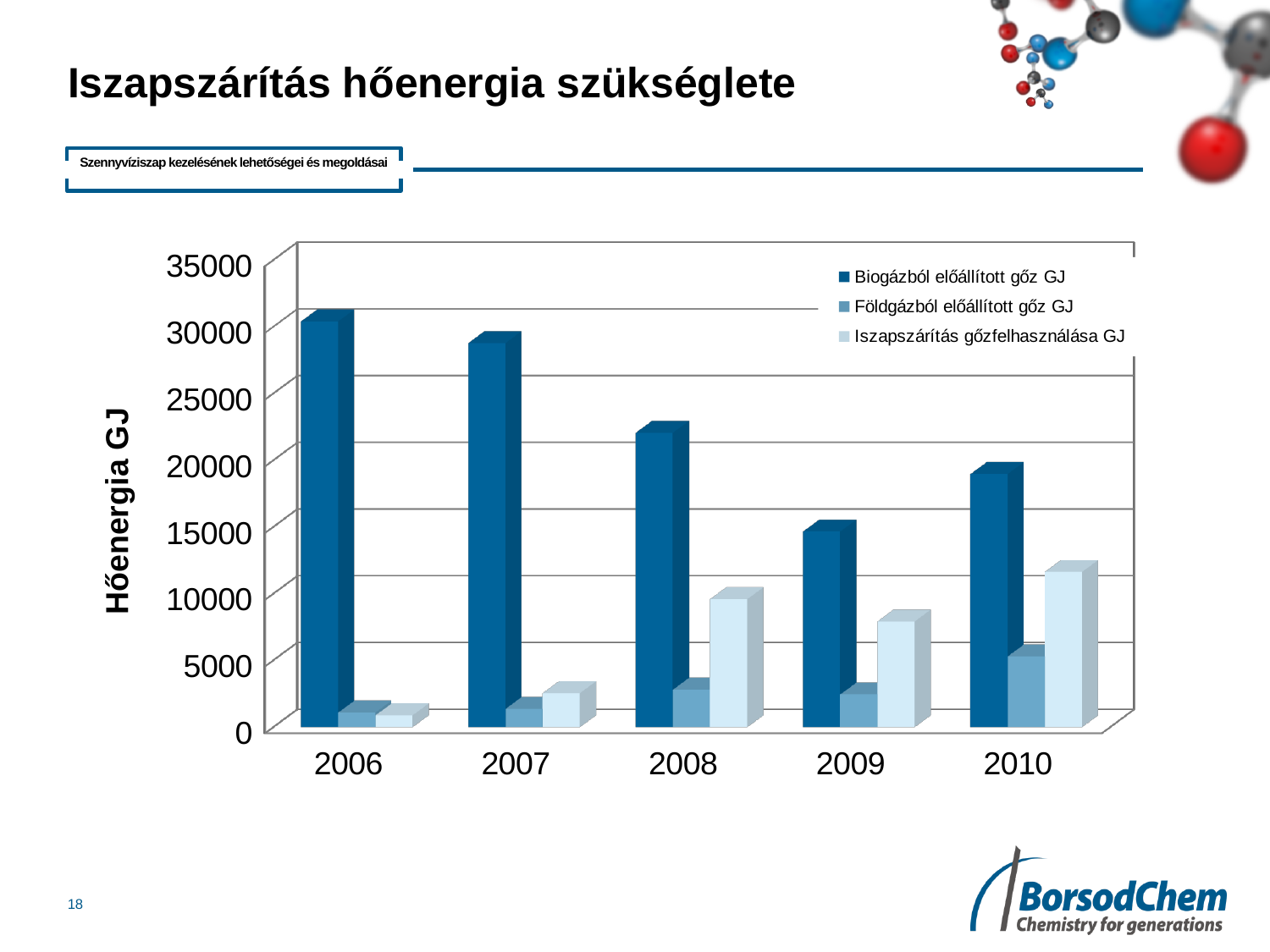
Is the value for Biogázból előállított gőz GJ in 2006 greater or less than 25000? greater How many years are shown on the x axis? 5 What kind of chart is shown on the slide? bar chart In which year is the value for Biogázból előállított gőz GJ lowest? 2009 Which series is listed first in the legend? Biogázból előállított gőz GJ Which is larger: Biogázból előállított gőz GJ in 2006 or in 2010? 2006 In which year is the value for Iszapszárítás gőzfelhasználása GJ highest? 2010 In which year is the value for Biogázból előállított gőz GJ highest? 2006 How many series does the legend list? 3 What is the title of the vertical axis? Hőenergia GJ Is the value for Biogázból előállított gőz GJ in 2009 greater or less than 20000? less Does the value for Biogázból előállított gőz GJ rise or fall from 2006 to 2009? fall